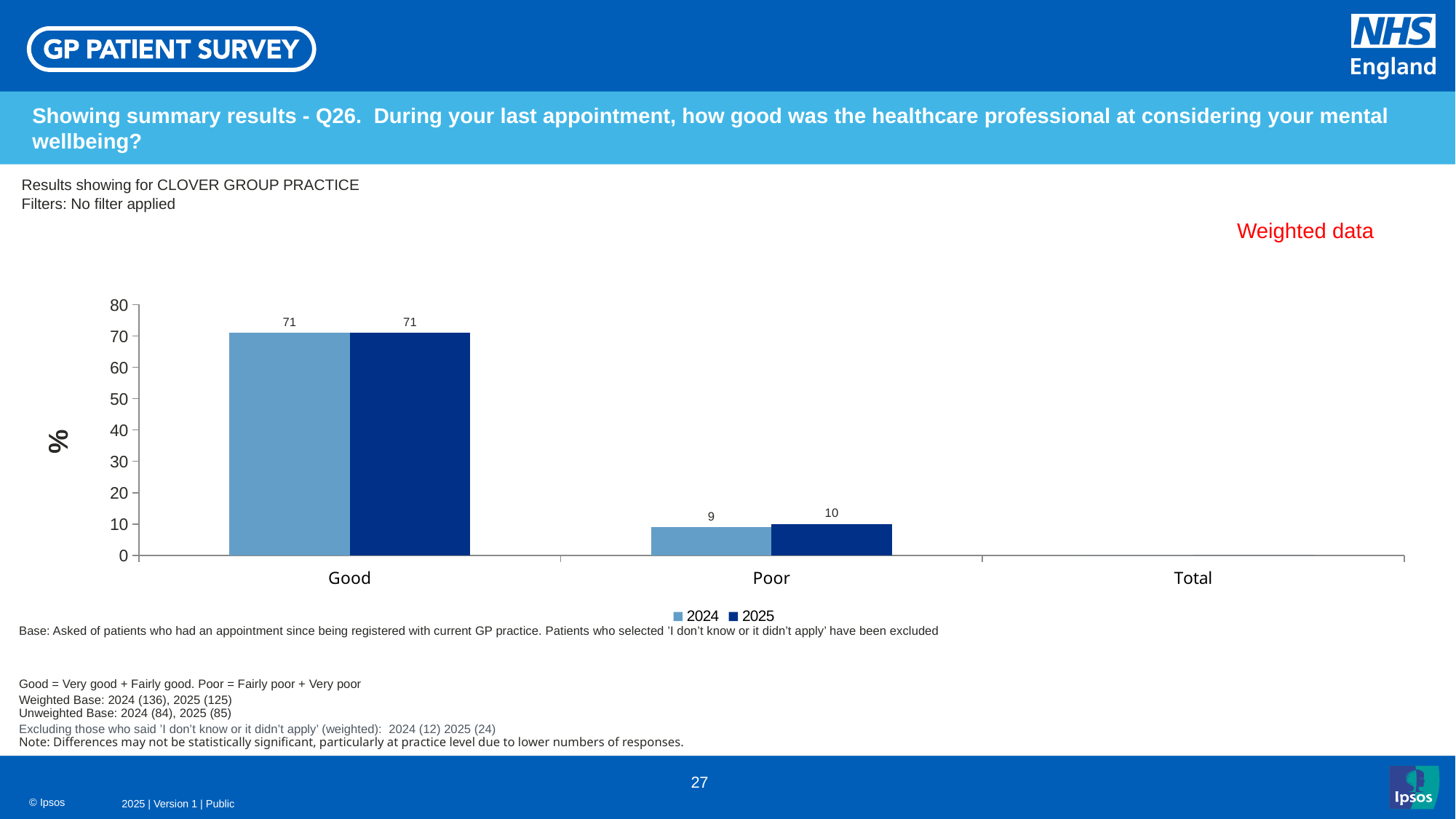
What is the value for Poor in 2025? 10 Which category has the highest value in 2024, Good or Poor? Good What is the difference between the Good and Poor values for 2025? 61 What is the difference between the 2025 and 2024 values for Poor? 1 What is the value for Good in 2024? 71 Is the value for Good in 2025 greater or less than 60? greater What is the value for Good in 2025? 71 Is the value for Poor in 2025 larger or smaller than the value for Poor in 2024? larger What is the value for Poor in 2024? 9 Which category has the lowest value in 2025? Poor What kind of chart is shown on the slide? bar chart How many series does the legend list? 2